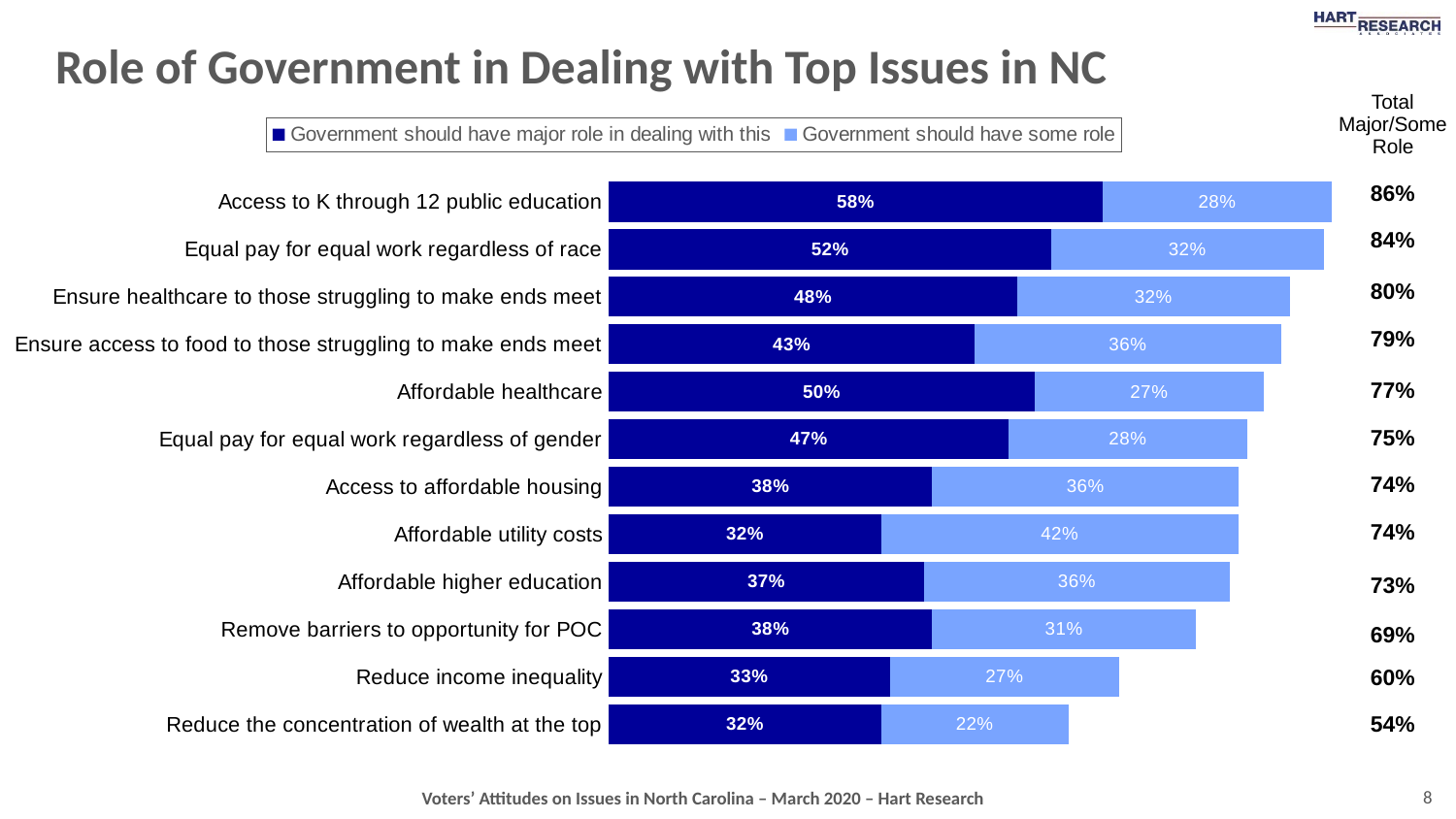
How many series does the legend list? 2 What is the total Major/Some Role percentage for reduce income inequality? 60% What is the combined 'major role' and 'some role' percentage for access to affordable housing? 74% How many issues are listed in the chart? 12 What percentage say government should have a major role in dealing with access to K through 12 public education? 58% What percentage say government should have some role in dealing with affordable utility costs? 42% Which issue has the highest percentage saying government should have a major role? Access to K through 12 public education Which is larger: the 'major role' percentage for equal pay for equal work regardless of race or for equal pay for equal work regardless of gender? Equal pay for equal work regardless of race What kind of chart is shown on the slide? Stacked bar chart What is the difference between the 'major role' percentages for affordable healthcare and affordable higher education? 13% What is the title of the chart? Role of Government in Dealing with Top Issues in NC Which issue has the lowest percentage saying government should have some role? Reduce the concentration of wealth at the top